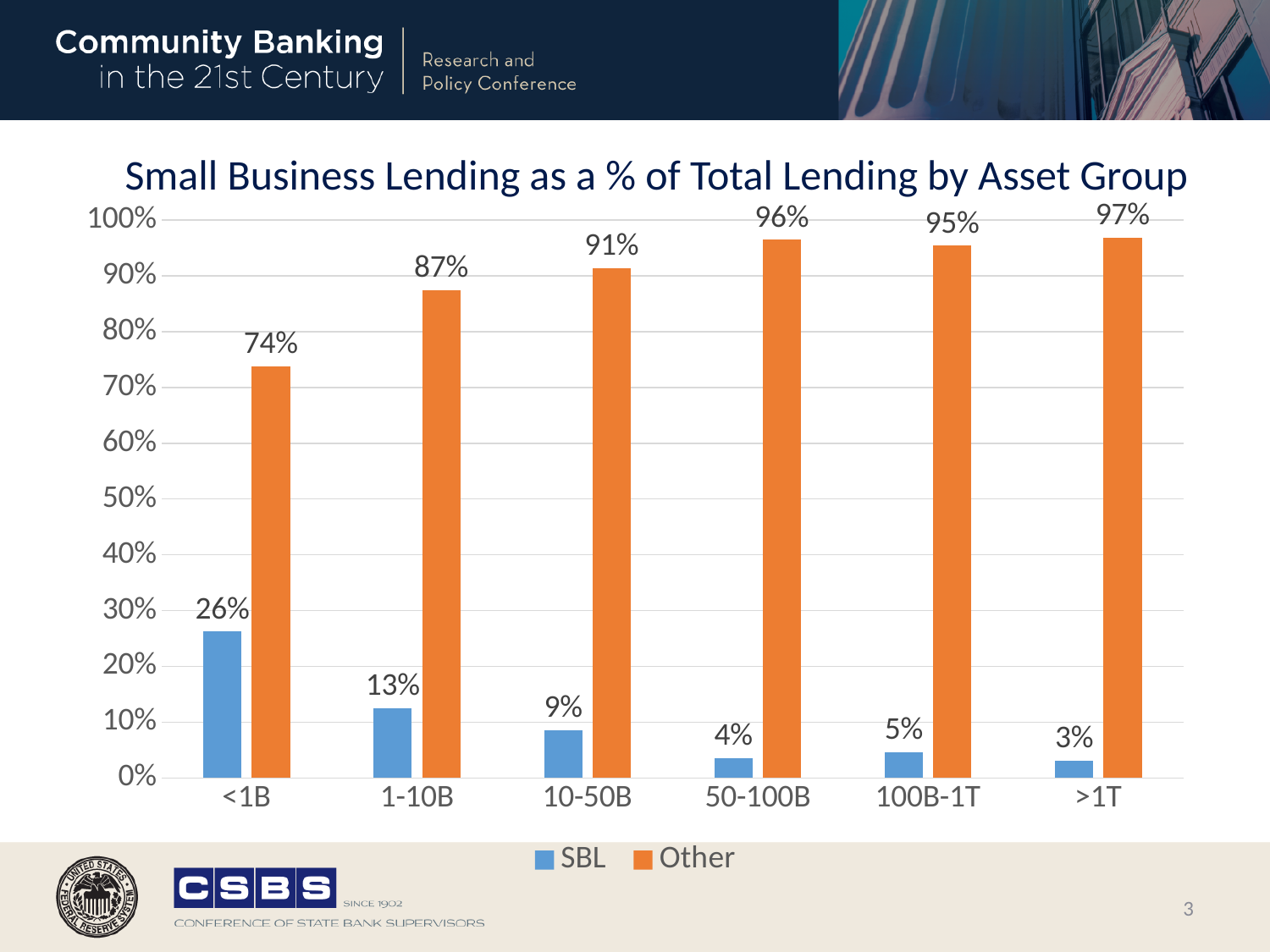
Which is larger, the SBL value for 1-10B or the SBL value for 10-50B? 1-10B Which asset group has the highest SBL value? <1B What is the title of the chart? Small Business Lending as a % of Total Lending by Asset Group What is the SBL value for the 100B-1T asset group? 5% What is the Other value for the 10-50B asset group? 91% How many series does the legend list? 2 Do the SBL values rise or fall from <1B to 50-100B along the x axis? Fall Which asset group has the lowest SBL value? >1T How many asset groups are shown on the x axis? 6 What is the SBL value for the <1B asset group? 26% What is the difference between the Other value and the SBL value for the 1-10B asset group? 74% What kind of chart is shown on the slide? Bar chart